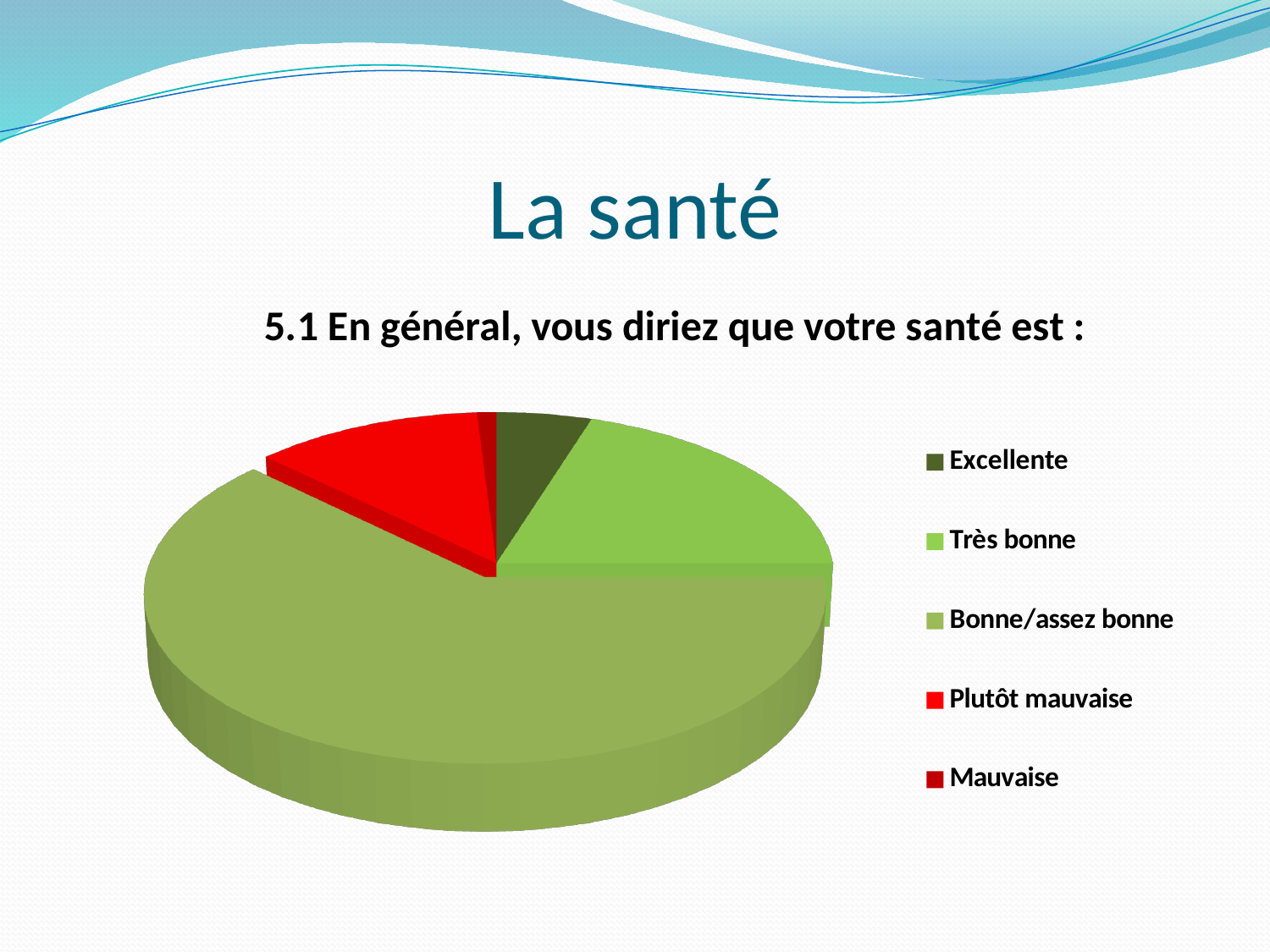
Which slice is larger, Très bonne or Excellente? Très bonne How many categories does the legend of the pie chart list? 5 Which category has the largest slice of the pie chart? Bonne/assez bonne What kind of chart is shown on the slide? pie chart What is the title of the chart on the slide? 5.1 En général, vous diriez que votre santé est : Which slice is larger, Plutôt mauvaise or Excellente? Plutôt mauvaise Which slice is larger, Bonne/assez bonne or Très bonne? Bonne/assez bonne What colour is the Plutôt mauvaise slice in the pie chart? red How many slices does the pie chart have? 5